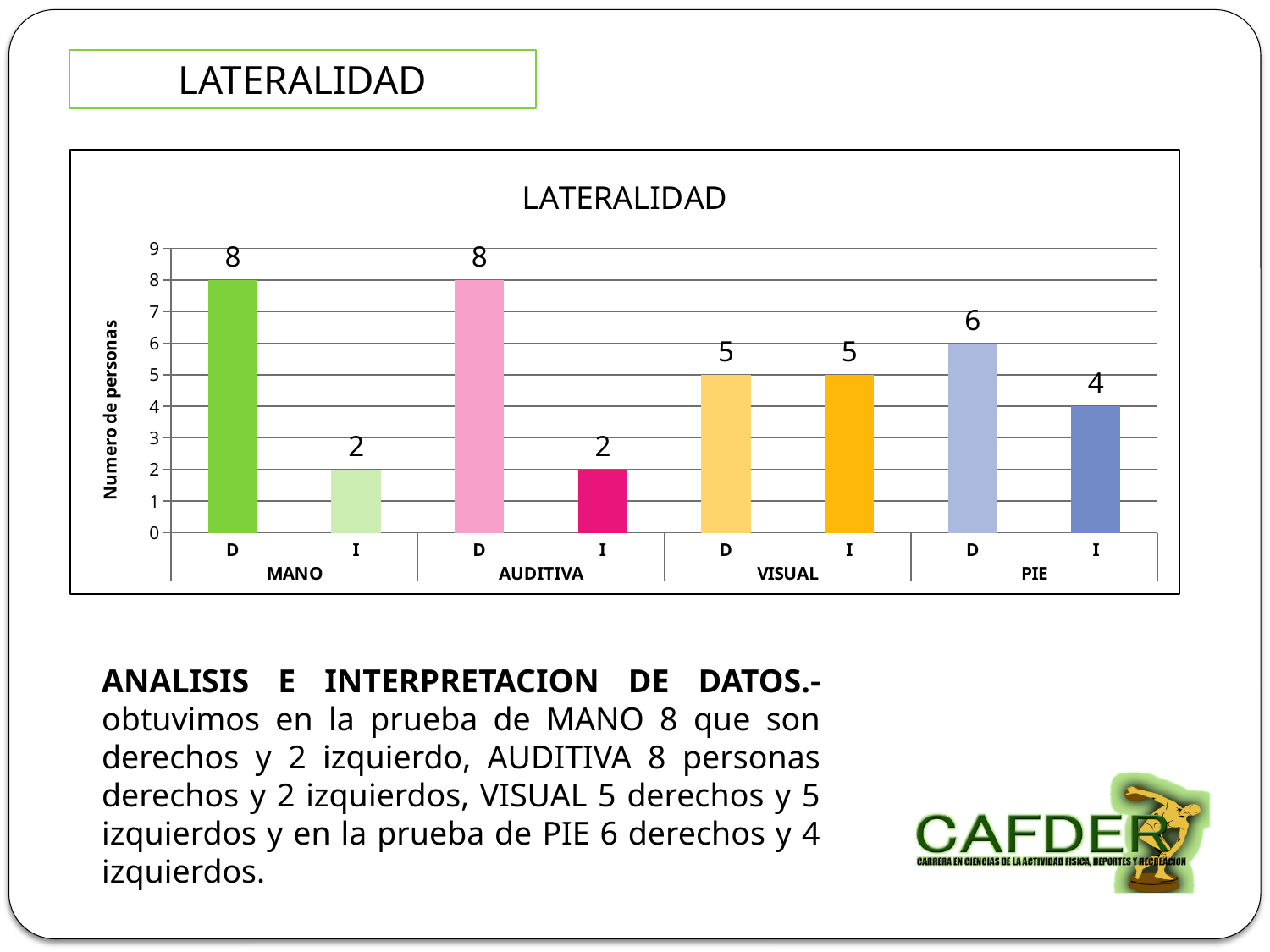
What is the label of the y axis? Numero de personas Which group has the lowest value for I? MANO and AUDITIVA (both 2) Which is larger in the PIE group, D or I? D What is the value for D in the MANO group? 8 How many groups are shown on the x axis? 4 What is the value for D in the VISUAL group? 5 What is the difference between D and I in the PIE group? 2 What is the value for I in the PIE group? 4 What is the value for I in the AUDITIVA group? 2 What kind of chart is shown? Bar chart How many bars are plotted in the chart? 8 What is the difference between D and I in the MANO group? 6